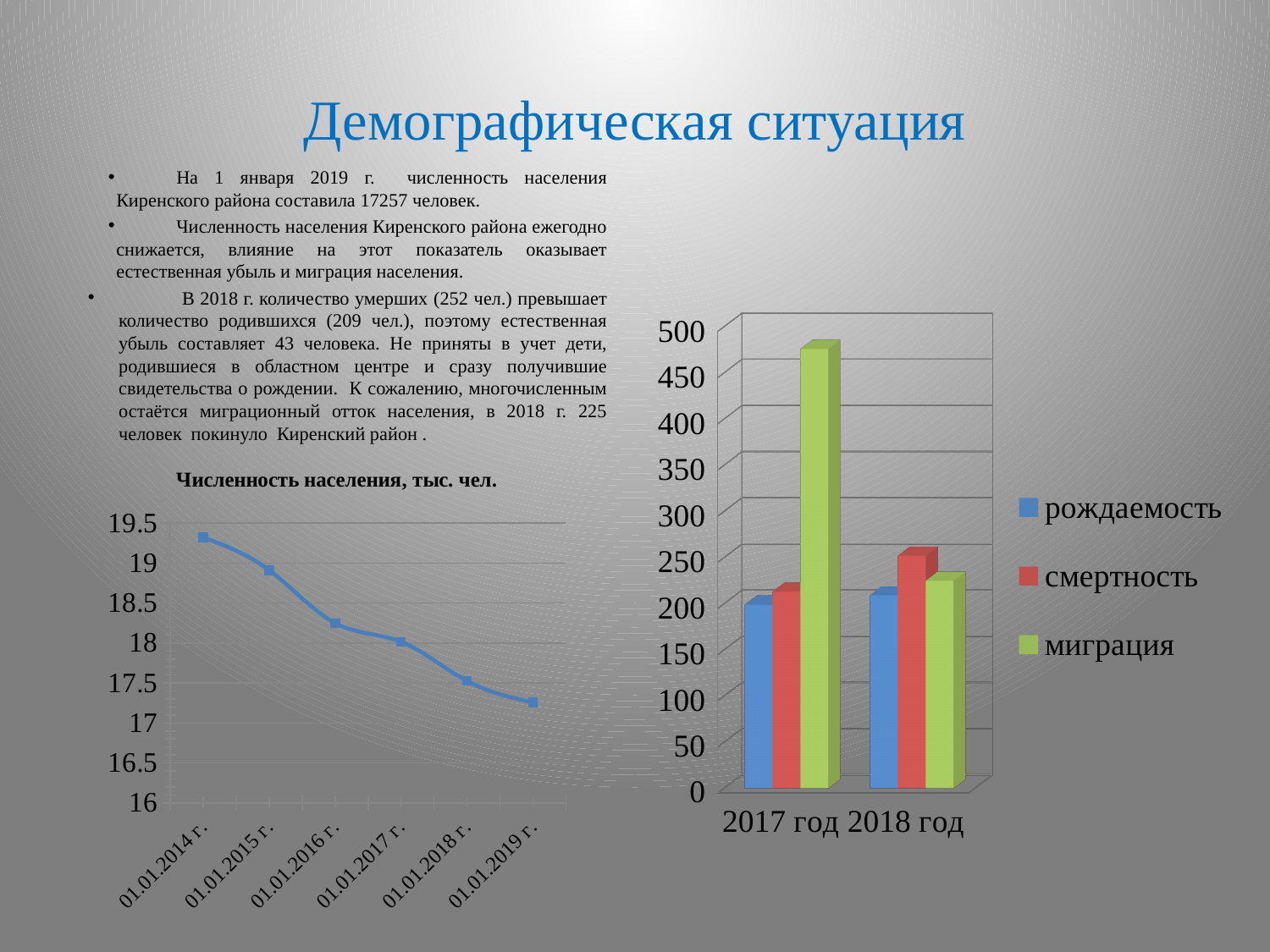
In the bar chart on the right, how many series does the legend list? 3 In the chart titled "Численность населения, тыс. чел.", which date has the lowest value? 01.01.2019 г. What kind of chart is the chart titled "Численность населения, тыс. чел."? line chart In the chart titled "Численность населения, тыс. чел.", is the value for 01.01.2019 г. greater or less than 17.5? less In the chart titled "Численность населения, тыс. чел.", do the values rise or fall from 01.01.2014 г. to 01.01.2019 г.? fall What kind of chart is the chart on the right of the slide? bar chart In the bar chart on the right, which series has the highest value for 2017 год? миграция In the chart titled "Численность населения, тыс. чел.", how many data points are plotted? 6 In the chart titled "Численность населения, тыс. чел.", is the value for 01.01.2014 г. greater or less than 19? greater In the bar chart on the right, is the value of миграция larger for 2017 год or 2018 год? 2017 год In the chart titled "Численность населения, тыс. чел.", which date has the highest value? 01.01.2014 г. In the bar chart on the right, is the value of миграция for 2017 год greater or less than 450? greater